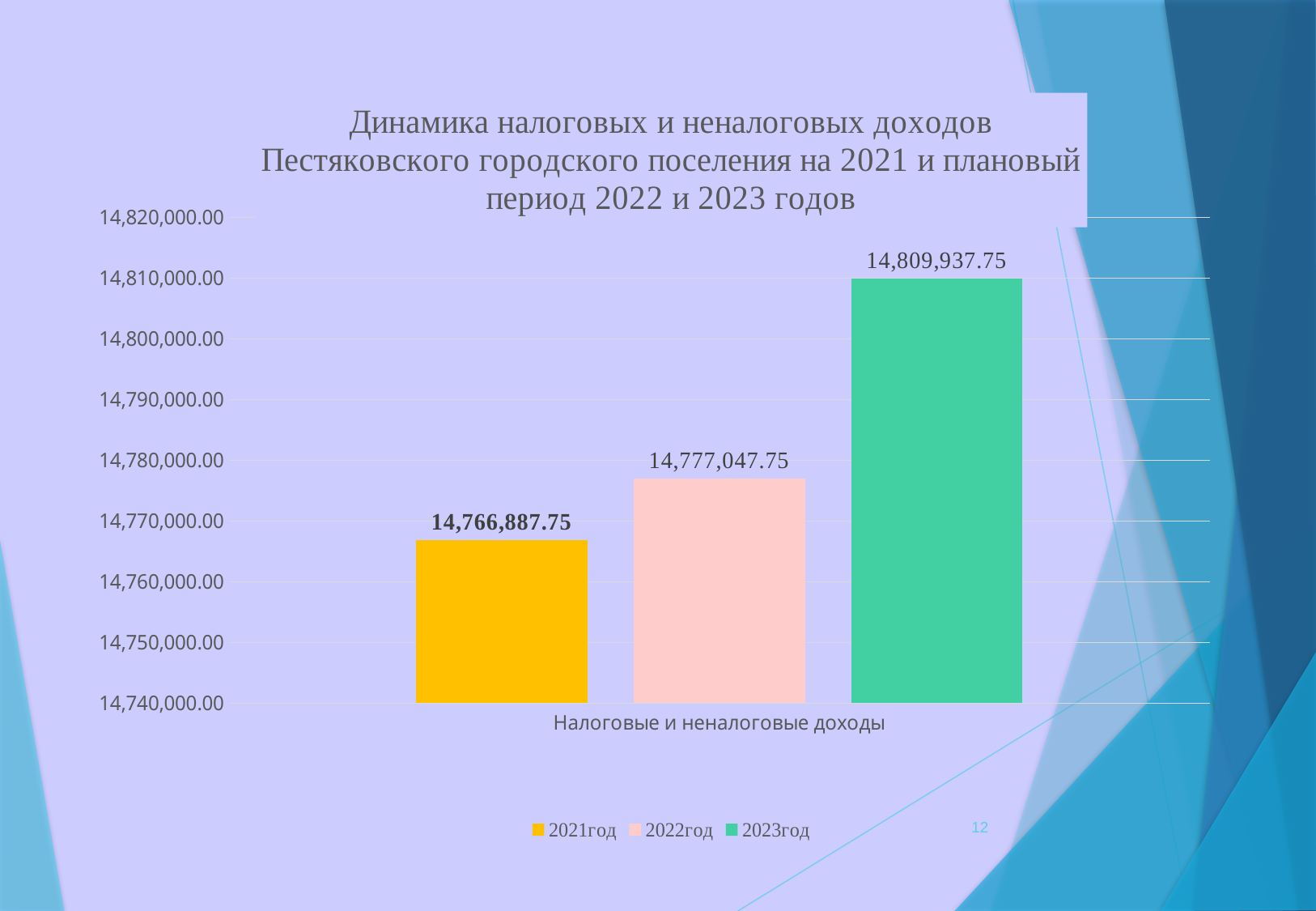
How many series does the legend list? 3 What type of chart is shown on the slide? bar chart What is the value for 2022год (Налоговые и неналоговые доходы)? 14,777,047.75 What is the value for 2021год (Налоговые и неналоговые доходы)? 14,766,887.75 Which year has the highest value? 2023год What is the value for 2023год (Налоговые и неналоговые доходы)? 14,809,937.75 What is the difference between the values for 2022год and 2021год? 10,160.00 Is the value for 2022год greater or less than 14,780,000.00? less Which year has the lowest value? 2021год What is the difference between the values for 2023год and 2022год? 32,890.00 What is the category label shown on the x axis? Налоговые и неналоговые доходы Which is larger, the value for 2021год or the value for 2023год? 2023год